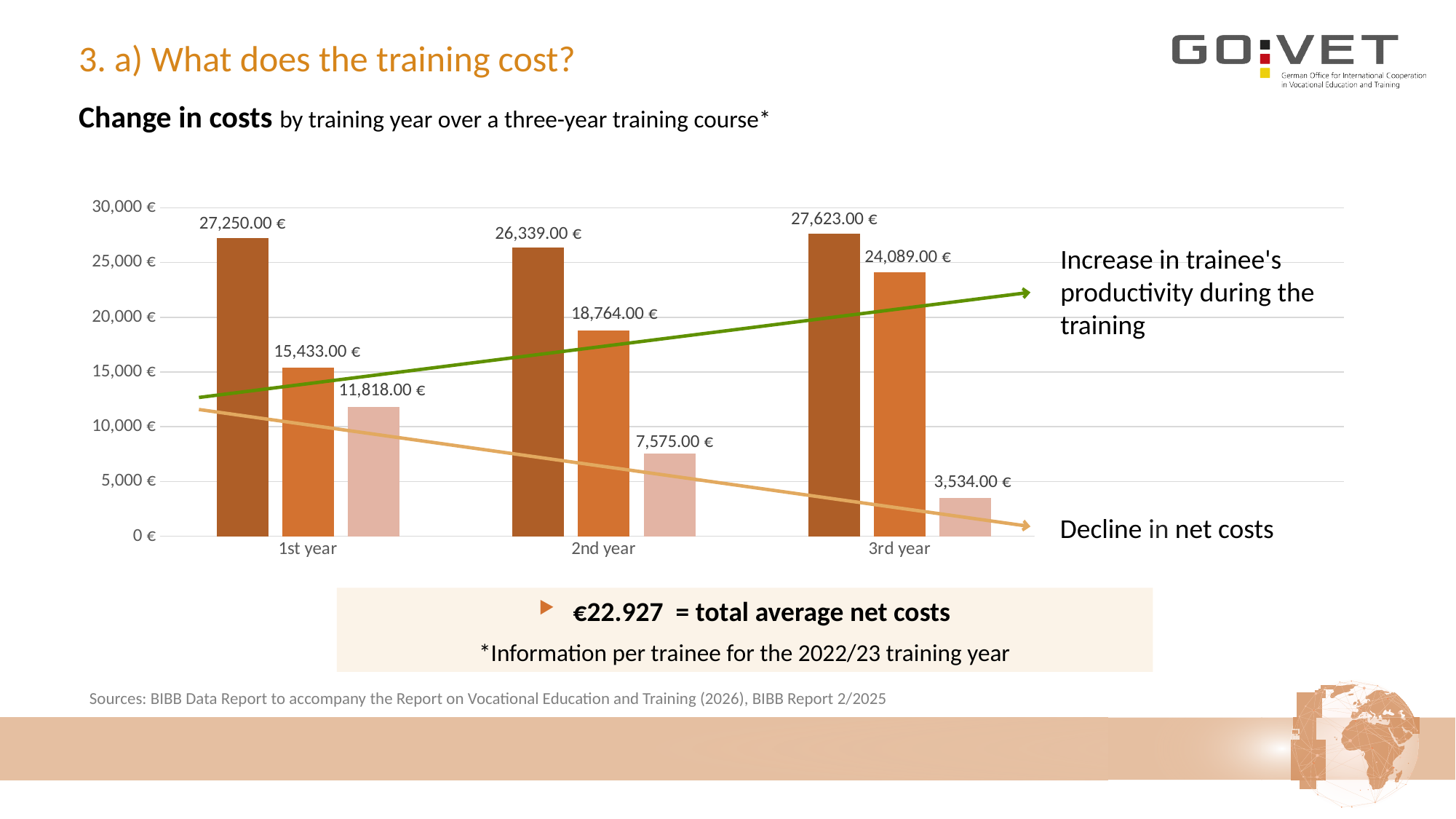
What kind of chart is shown on the slide? Bar chart Which is larger: the light pink bar for the 2nd year or the light pink bar for the 3rd year? 2nd year Which training year has the highest value for the light pink bar? 1st year Which training year has the lowest value for the dark brown bar? 2nd year What does the green arrow on the chart represent, according to its label? Increase in trainee's productivity during the training Do the values of the light pink bars rise or fall from the 1st year to the 3rd year? Fall Do the values of the orange bars rise or fall from the 1st year to the 3rd year? Rise What is the value of the light pink bar for the 3rd year? 3,534.00 € What is the difference between the orange bar values for the 3rd year and the 1st year? 8,656.00 € What is the value of the tallest (dark brown) bar for the 1st year? 27,250.00 € How many training years are shown on the x axis? 3 What is the value of the middle (orange) bar for the 2nd year? 18,764.00 €